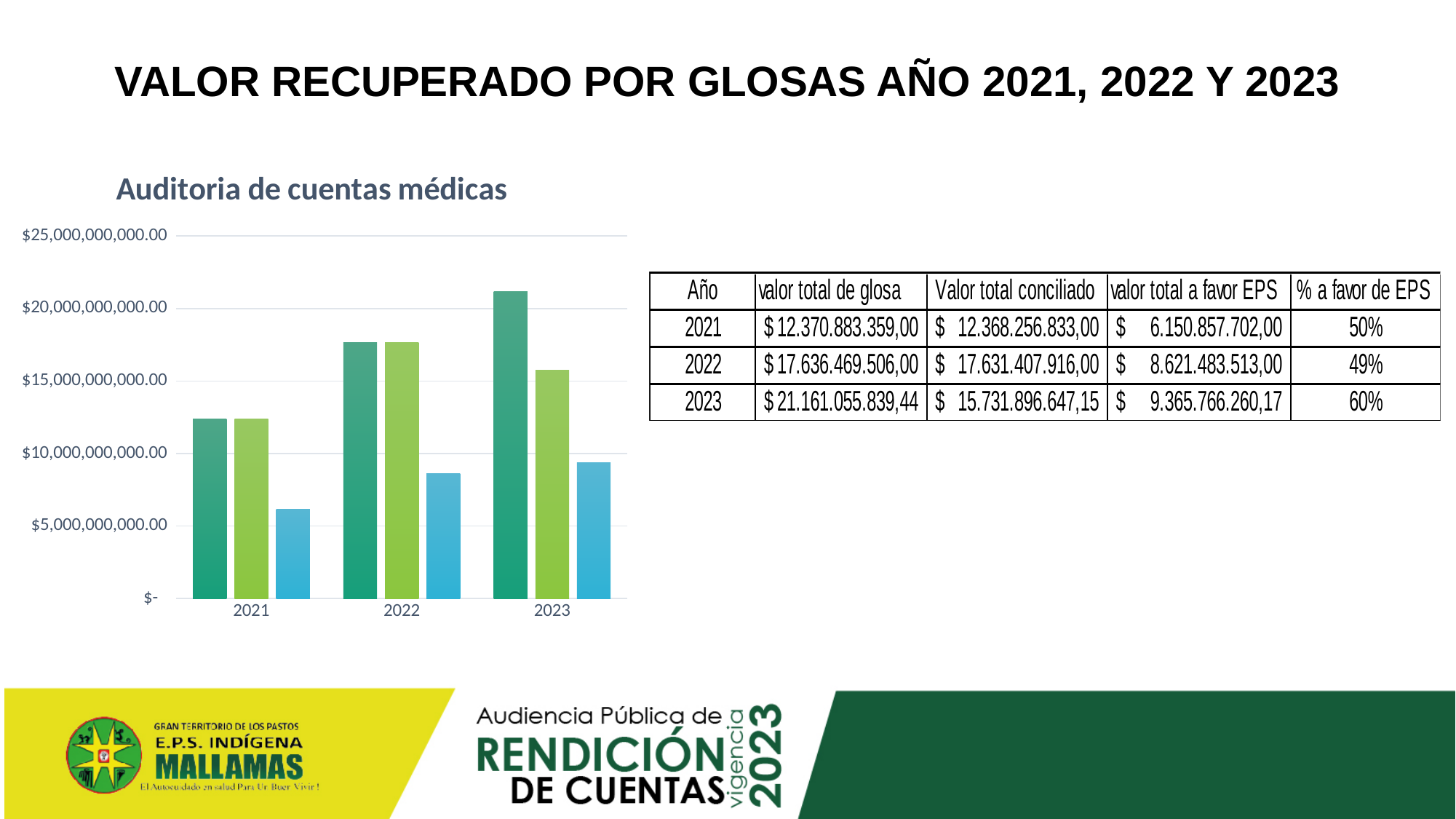
Is the tallest bar for 2023 greater or less than $20,000,000,000.00? greater How many year categories are shown on the x axis of the chart? 3 What is the title of the chart? Auditoria de cuentas médicas What kind of chart is shown on the slide? bar chart Which year contains the tallest bar in the chart? 2023 Is the shortest (blue) bar for 2021 greater or less than $5,000,000,000.00? greater How many bars are plotted for each year in the chart? 3 Is the blue bar for 2022 greater or less than $10,000,000,000.00? less Does the first (dark green) bar rise or fall from 2021 to 2023? rise Which year contains the shortest bar in the chart? 2021 Which is larger: the first (dark green) bar for 2021 or the first (dark green) bar for 2022? 2022